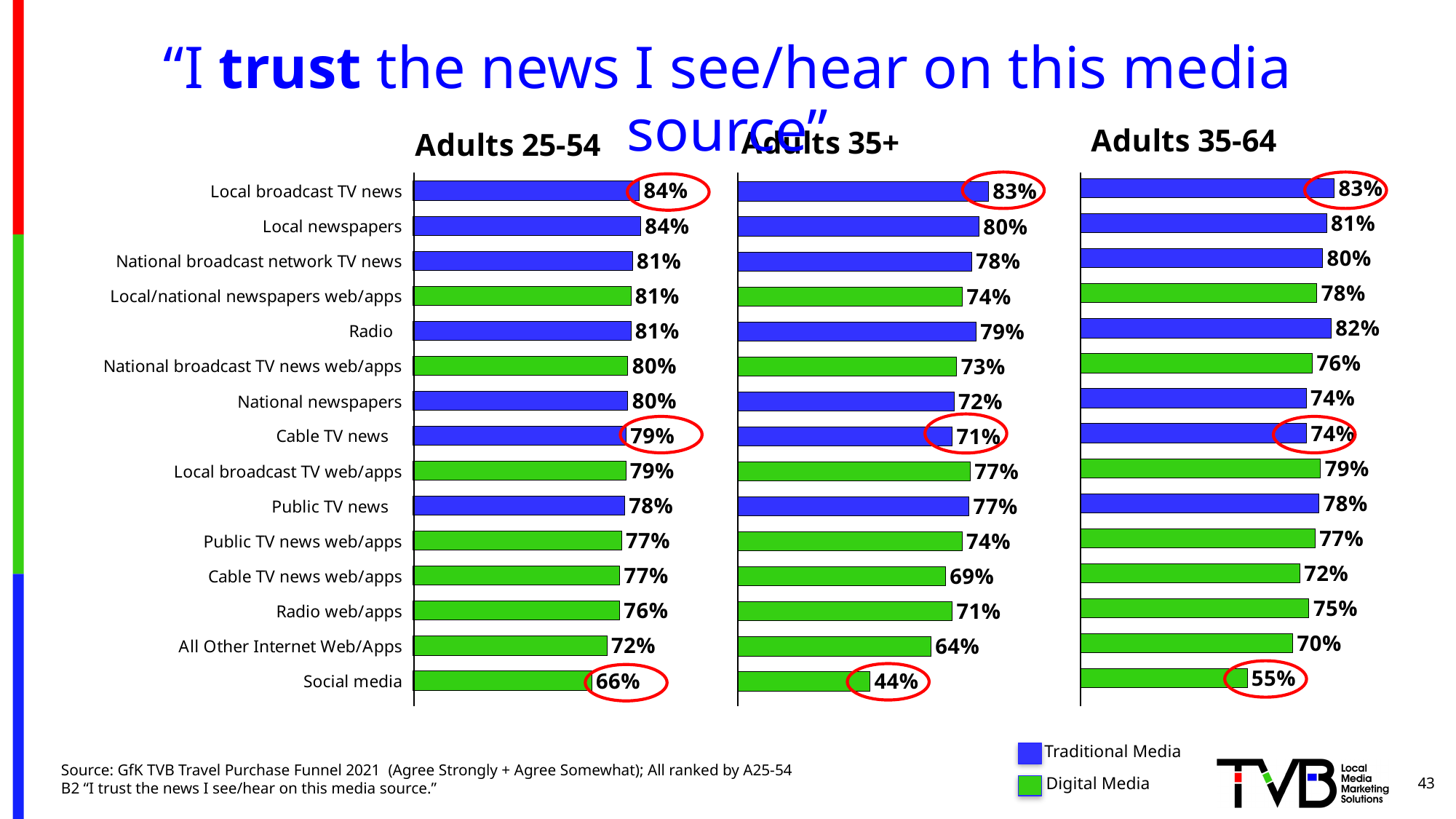
What type of chart is used for the Adults 35+ data? Bar chart How many categories are shown in the Adults 25-54 chart? 15 In the Adults 25-54 chart, what is the value for Social media? 66% In the Adults 35+ chart, which category has the lowest value? Social media In the Adults 35-64 chart, which category has the highest value? Local broadcast TV news In the Adults 25-54 chart, what is the difference between Local broadcast TV news and Social media? 18% In the Adults 35-64 chart, what is the value for Radio? 82% In the Adults 35+ chart, what is the difference between Local broadcast TV news and Social media? 39% How many series does the legend list? 2 In the Adults 35-64 chart, which is larger: Local newspapers or National newspapers? Local newspapers In the Adults 35+ chart, what is the value for Cable TV news? 71% In the Adults 35+ chart, which category has the highest value? Local broadcast TV news